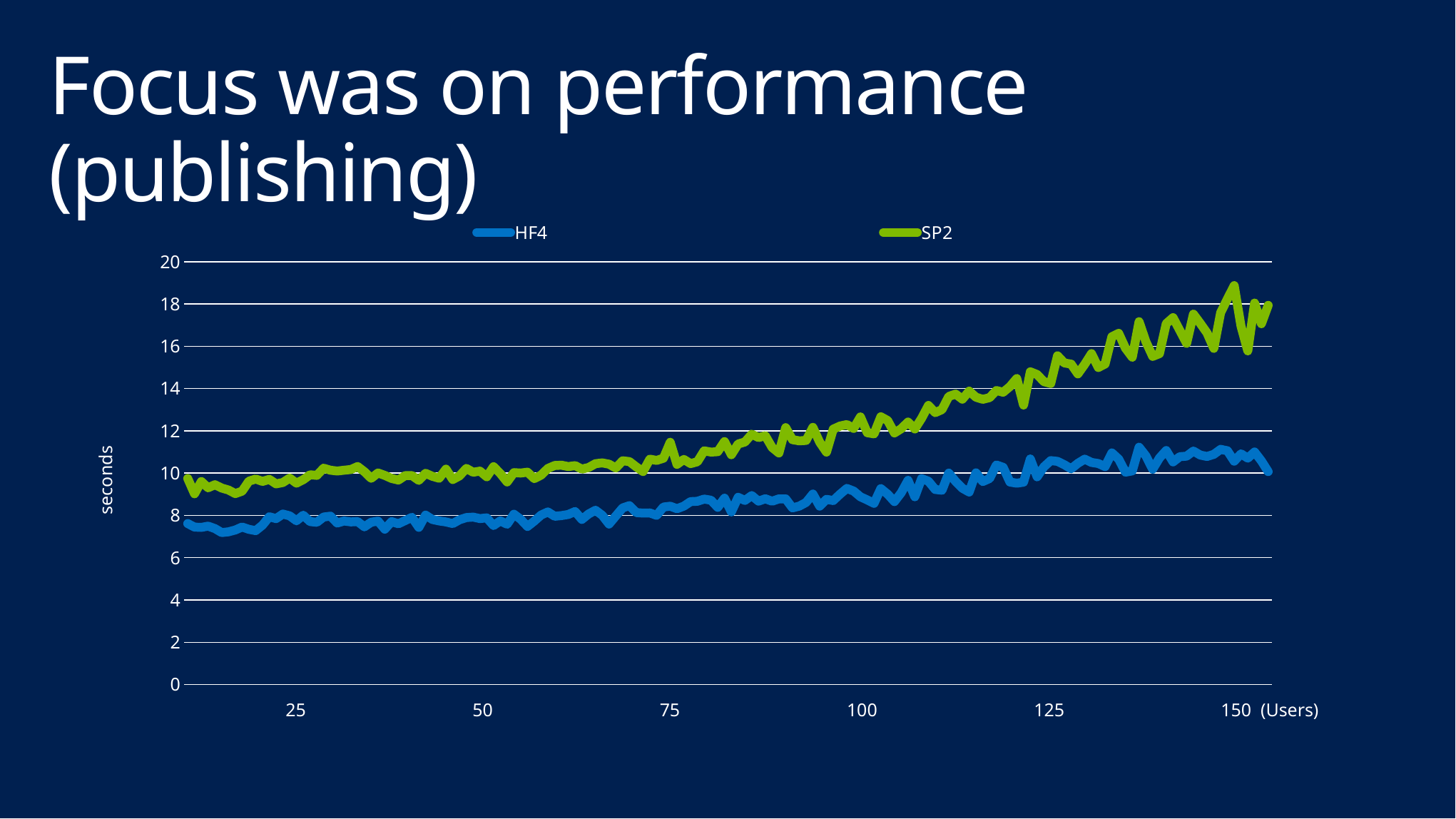
Does the SP2 line rise or fall as the number of users increases? rises Is the value for HF4 at 25 users greater or less than 10? less Is the value for SP2 at 150 users greater or less than 14? greater Is the value for HF4 at 150 users greater or less than 14? less Does the HF4 line rise or fall as the number of users increases? rises At 100 users, which series has the higher value, HF4 or SP2? SP2 How many series does the legend list? 2 What is the label on the vertical axis? seconds What kind of chart is shown on the slide? line chart At 150 users, which series has the higher value, HF4 or SP2? SP2 What are the two series named in the legend? HF4 and SP2